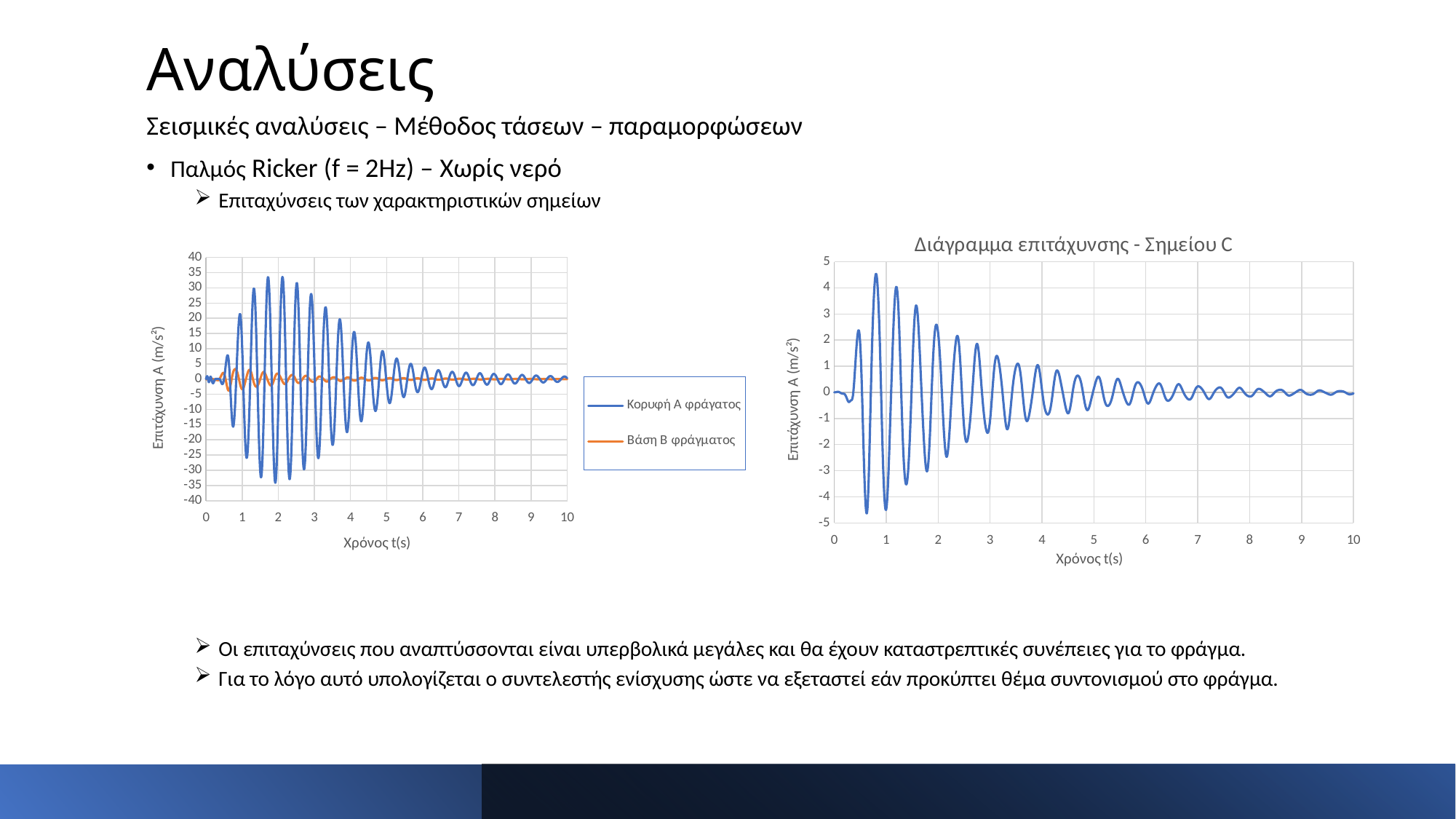
In the chart titled 'Διάγραμμα επιτάχυνσης - Σημείου C', does the amplitude of the oscillation increase or decrease as time goes from 2 s to 10 s? decrease What kind of chart is the chart titled 'Διάγραμμα επιτάχυνσης - Σημείου C'? Line chart What is the title of the right chart? Διάγραμμα επιτάχυνσης - Σημείου C In the chart titled 'Διάγραμμα επιτάχυνσης - Σημείου C', is the lowest trough greater or less than -4? less What kind of chart is the left chart on the slide? Line chart In the left chart, is the maximum value of the 'Βάση Β φράγματος' series greater or less than 10? less In the left chart, which series is drawn in orange? Βάση Β φράγματος How many series does the legend of the left chart list? 2 In the chart titled 'Διάγραμμα επιτάχυνσης - Σημείου C', is the highest peak greater or less than 4? greater In the left chart, which series reaches larger peak values, 'Κορυφή Α φράγατος' or 'Βάση Β φράγματος'? Κορυφή Α φράγατος What is the maximum value shown on the y axis of the left chart? 40